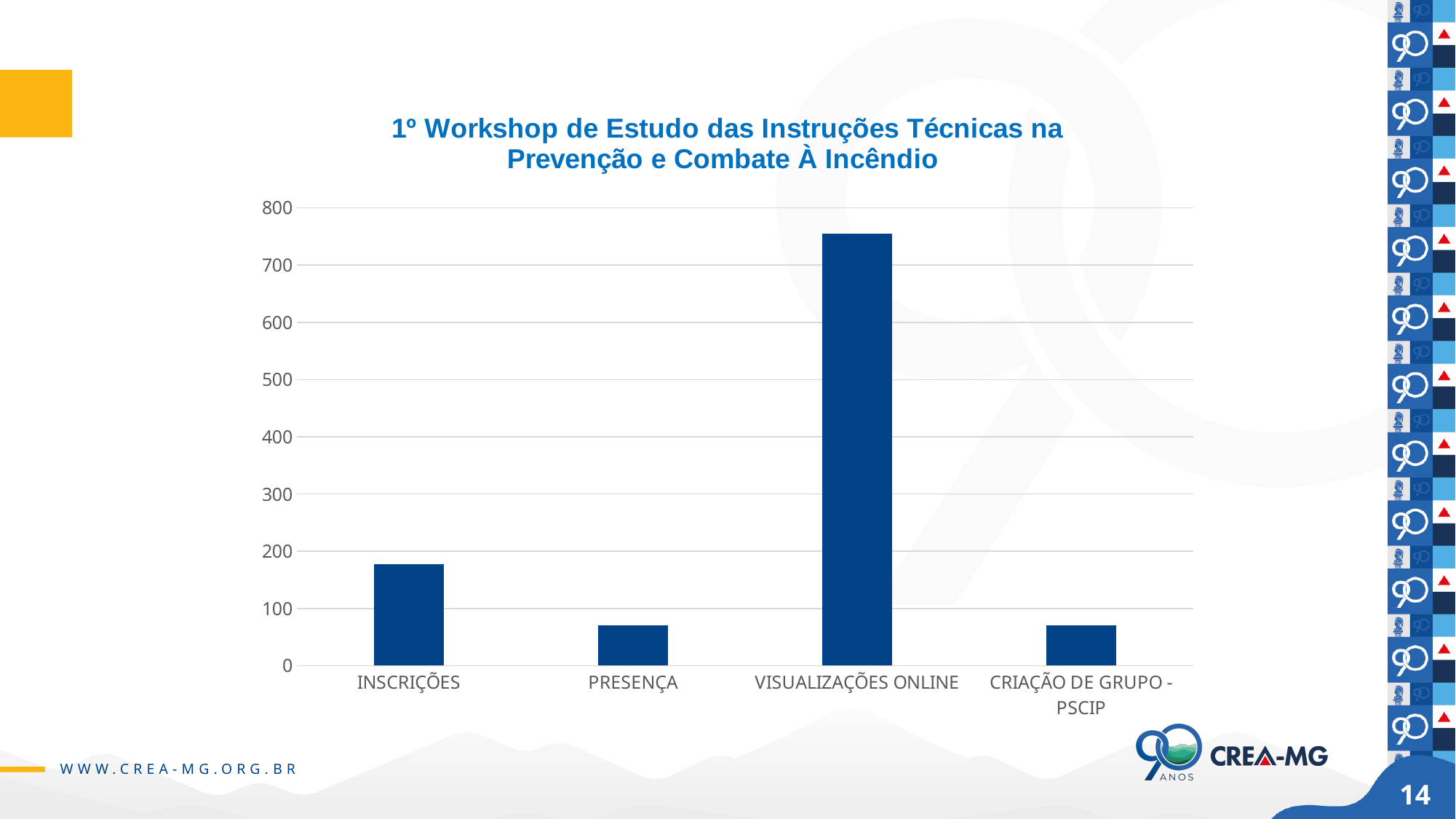
Is the value for VISUALIZAÇÕES ONLINE greater or less than 800? less Is the value for PRESENÇA greater or less than 100? less What kind of chart is shown on the slide? bar chart Is the value for INSCRIÇÕES greater or less than 100? greater How many categories are shown on the x axis of the chart? 4 Which is larger, the value for VISUALIZAÇÕES ONLINE or the value for INSCRIÇÕES? VISUALIZAÇÕES ONLINE Which category has the highest value in the chart? VISUALIZAÇÕES ONLINE What is the title of the chart? 1º Workshop de Estudo das Instruções Técnicas na Prevenção e Combate À Incêndio Which is larger, the value for INSCRIÇÕES or the value for PRESENÇA? INSCRIÇÕES